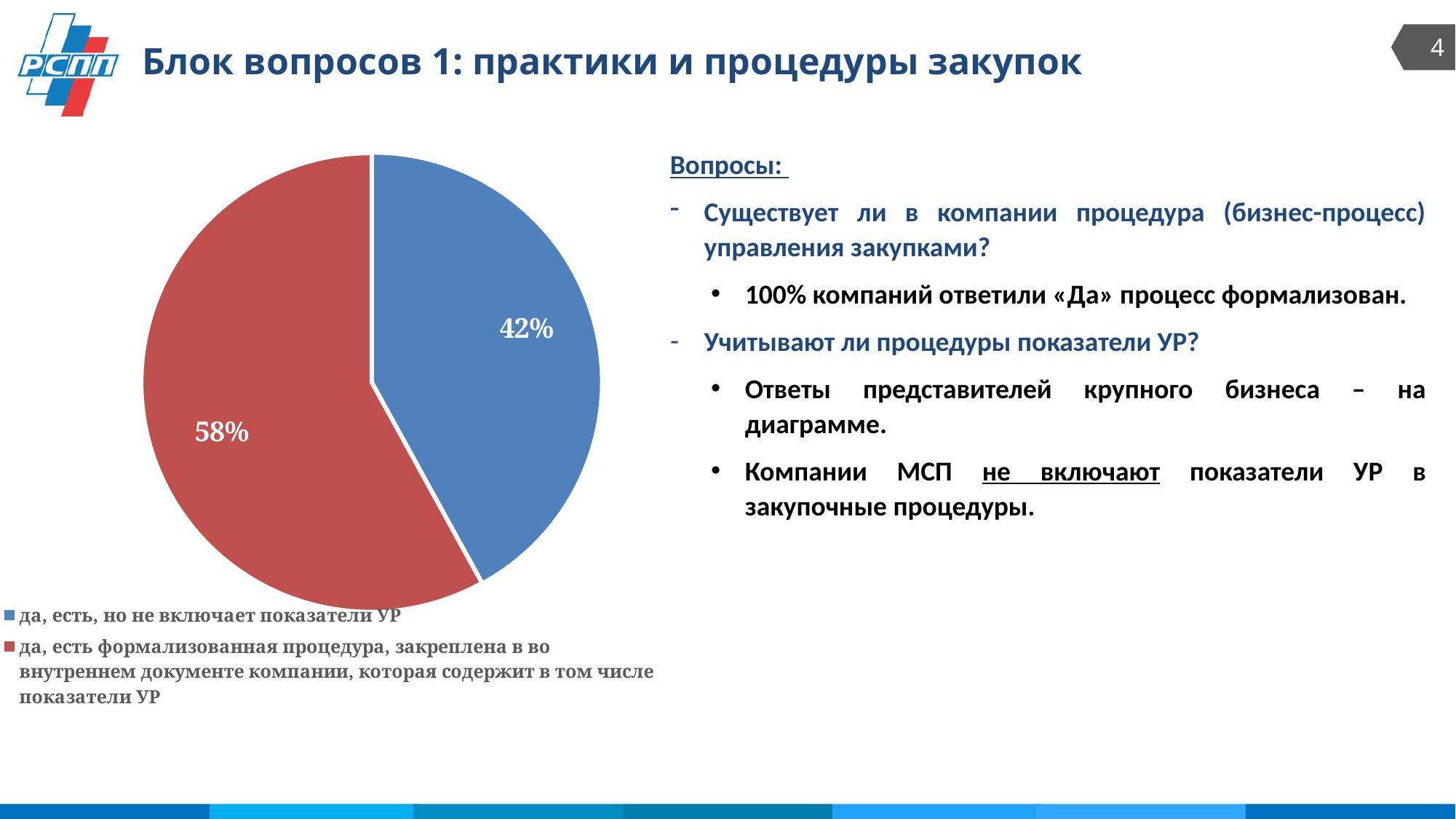
What is the total of the two pie slice percentages? 100% What kind of chart is shown on the slide? pie chart Which slice of the pie is the smallest? да, есть, но не включает показатели УР What is the difference in percentage points between the 58% slice and the 42% slice? 16 How many slices does the pie chart have? 2 What colour is the slice labelled 42%? blue How many entries does the legend list? 2 What share of the pie is labelled "да, есть формализованная процедура, закреплена в во внутреннем документе компании, которая содержит в том числе показатели УР"? 58% Which is larger: the slice for "да, есть, но не включает показатели УР" or the slice for the formalized procedure that includes УР indicators? the formalized procedure that includes УР indicators What colour is the slice labelled 58%? red Which slice of the pie is the largest? да, есть формализованная процедура, закреплена в во внутреннем документе компании, которая содержит в том числе показатели УР What share of the pie is labelled "да, есть, но не включает показатели УР"? 42%